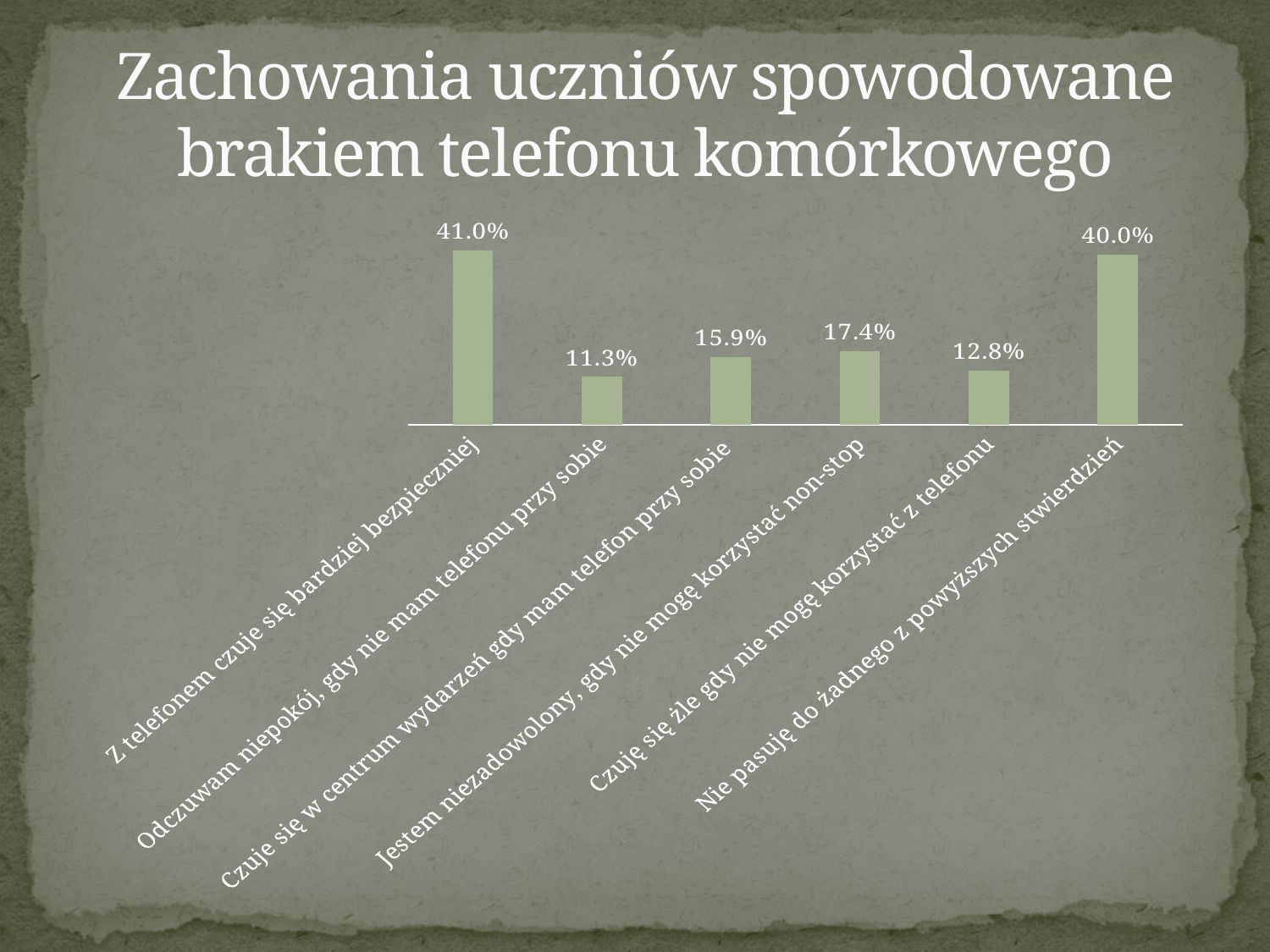
What is the value for "Czuje się w centrum wydarzeń gdy mam telefon przy sobie"? 15.9% What is the value for "Nie pasuję do żadnego z powyższych stwierdzeń"? 40.0% What is the difference between the values for "Z telefonem czuje się bardziej bezpieczniej" and "Nie pasuję do żadnego z powyższych stwierdzeń"? 1.0% Which category has the highest value? Z telefonem czuje się bardziej bezpieczniej What is the value for "Odczuwam niepokój, gdy nie mam telefonu przy sobie"? 11.3% What is the value for "Jestem niezadowolony, gdy nie mogę korzystać non-stop"? 17.4% What type of chart is shown on the slide? Bar chart Which is larger: the value for "Czuje się w centrum wydarzeń gdy mam telefon przy sobie" or for "Czuję się źle gdy nie mogę korzystać z telefonu"? Czuje się w centrum wydarzeń gdy mam telefon przy sobie Which category has the lowest value? Odczuwam niepokój, gdy nie mam telefonu przy sobie What is the difference between the values for "Jestem niezadowolony, gdy nie mogę korzystać non-stop" and "Czuję się źle gdy nie mogę korzystać z telefonu"? 4.6% What is the value for "Z telefonem czuje się bardziej bezpieczniej"? 41.0% How many categories are shown in the chart? 6